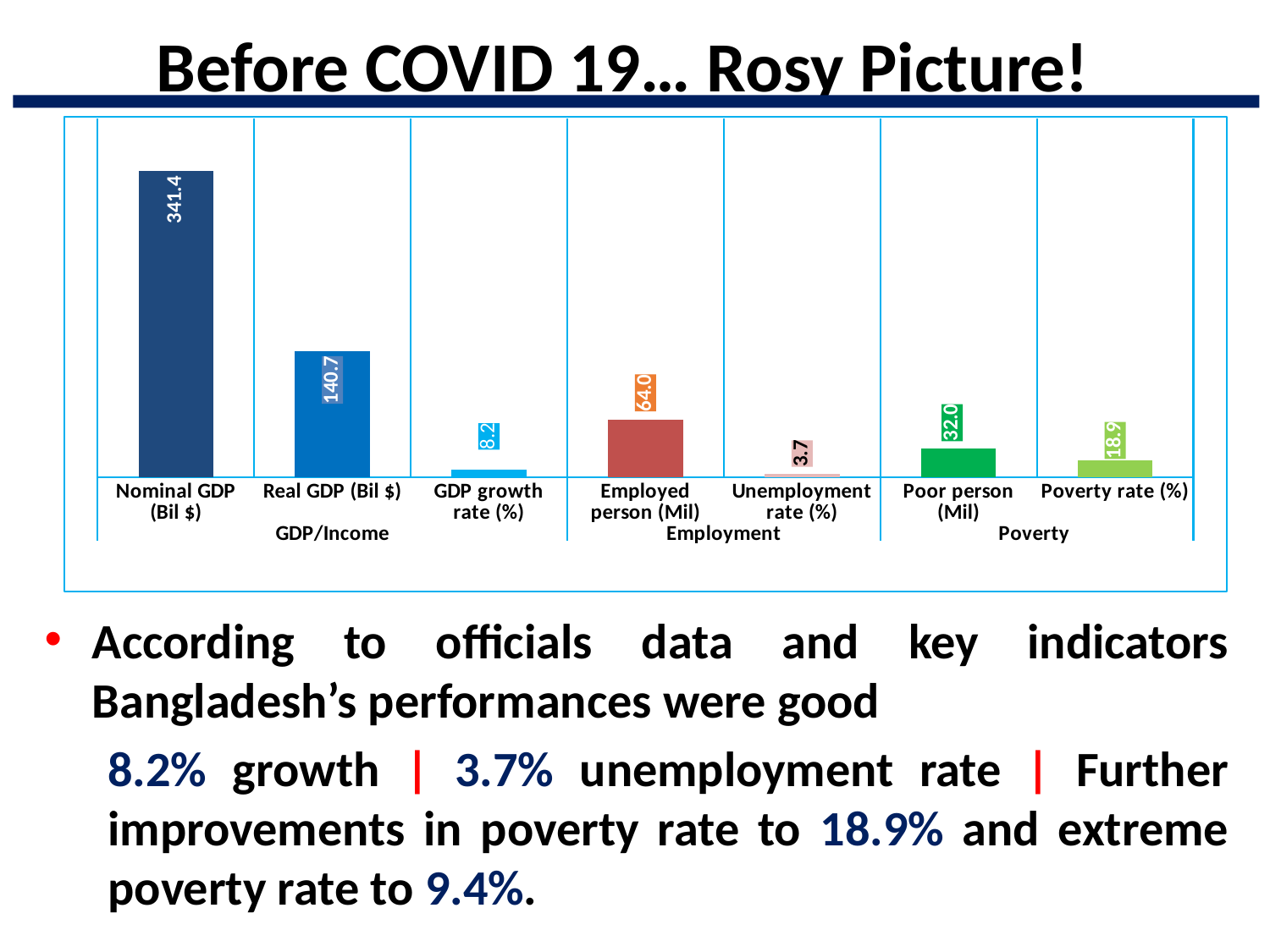
Which category has the lowest value in the chart? Unemployment rate (%) What is the value shown for Unemployment rate (%)? 3.7 What is the value shown for Nominal GDP (Bil $)? 341.4 What is the value shown for Poverty rate (%)? 18.9 What is the value shown for Real GDP (Bil $)? 140.7 What is the value shown for GDP growth rate (%)? 8.2 Which category has the highest value in the chart? Nominal GDP (Bil $) What is the value shown for Employed person (Mil)? 64.0 Which is larger, the value for Poor person (Mil) or the value for Poverty rate (%)? Poor person (Mil) How many bars are plotted in the chart? 7 What is the difference between the Nominal GDP (Bil $) and Real GDP (Bil $) values? 200.7 What type of chart is shown on the slide? Bar chart